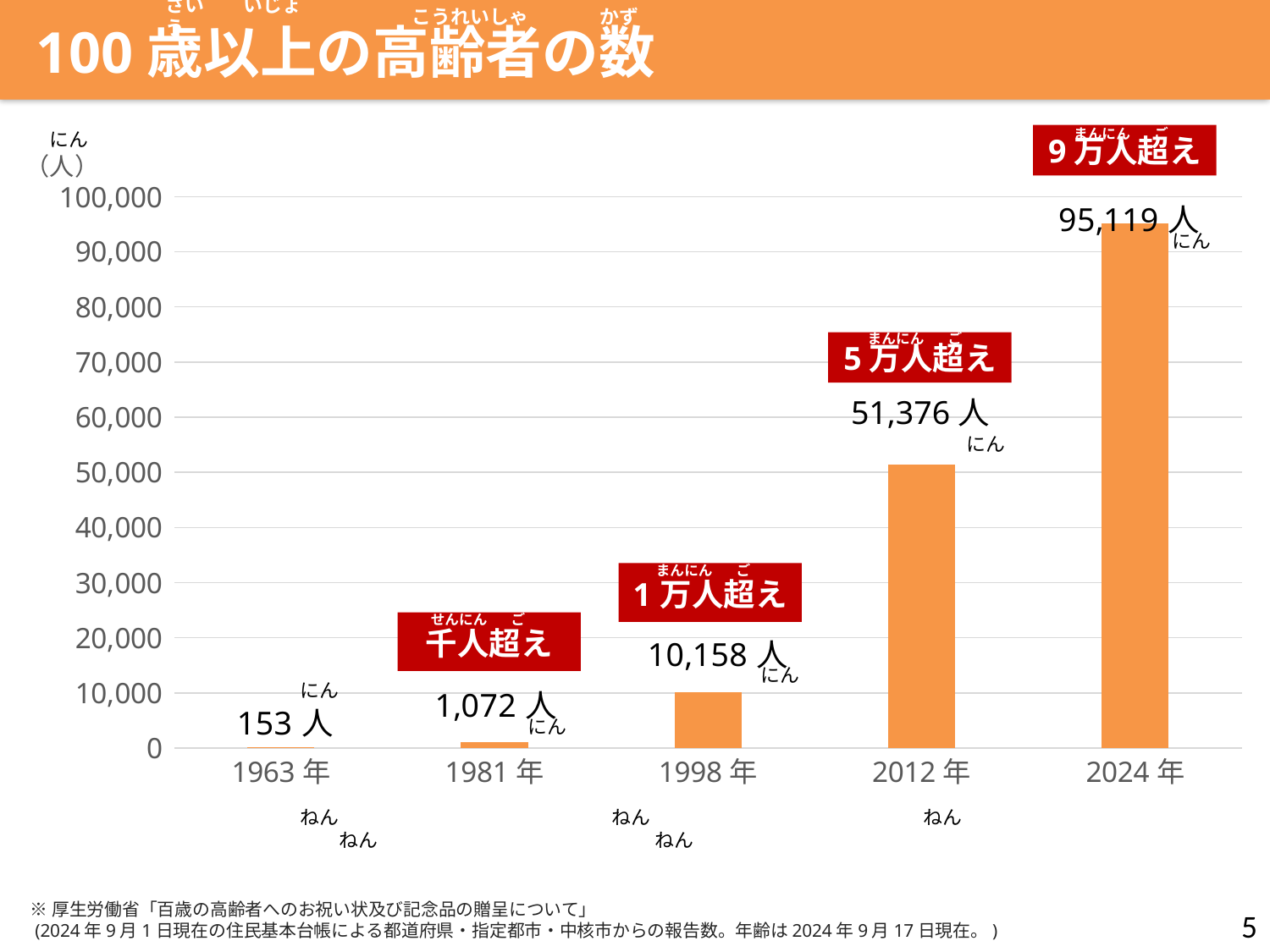
What kind of chart is this? bar chart What is the difference between the values for 1998 and 1981? 9,086 人 What is the number of people aged 100 and over in 2024? 95,119 人 What is the value shown for 1963? 153 人 Which year has the lowest value? 1963 年 How many years are shown on the x axis? 5 Which is larger, the value for 2012 or the value for 1998? 2012 年 What is the value shown for 1998? 10,158 人 Which year has the highest value? 2024 年 Is the value for 2012 greater or less than 50,000? greater Do the values rise or fall from 1963 to 2024? rise What is the difference between the values for 2024 and 2012? 43,743 人